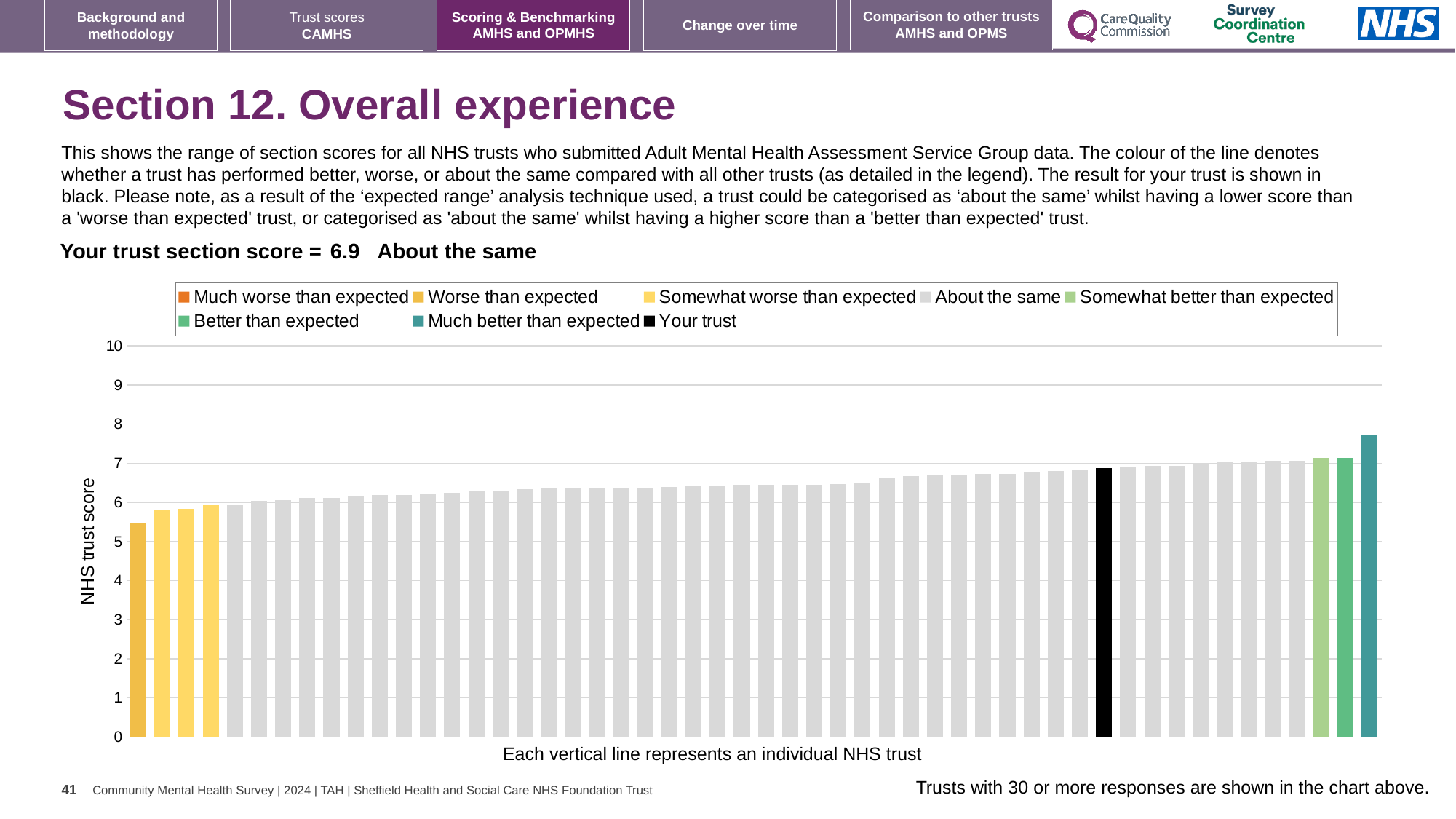
How many entries does the chart legend list? 8 What is the section score for your trust? 6.9 What kind of chart is shown on the slide? bar chart Is the value of the leftmost bar greater or less than 6? less How many bars are coloured as 'Worse than expected' (yellow)? 1 Is the value of the black bar (your trust) greater or less than 6? greater Is the value of the rightmost bar greater or less than 8? less Which category is your trust placed in for this section? About the same Which is higher, the leftmost bar or the rightmost bar? the rightmost bar Do the bar values rise or fall from left to right along the x axis? rise What is the label on the y axis of the chart? NHS trust score